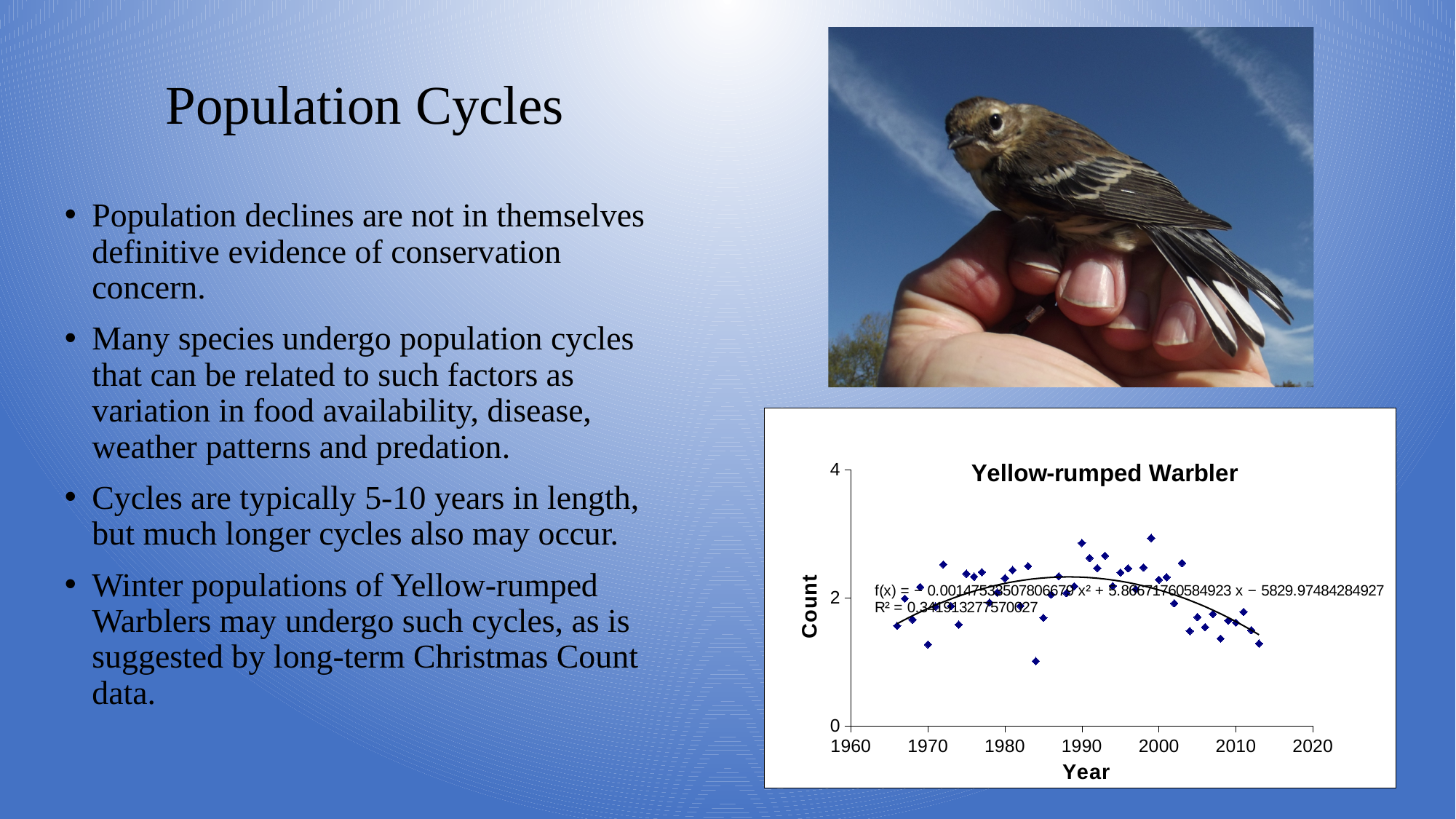
What is the highest value shown on the Count axis? 4 What kind of chart is shown on the slide? Scatter chart In which decade does the highest data point occur? 1990s What is the label on the vertical axis of the chart? Count What is the first year tick shown on the Year axis? 1960 What is the title of the chart? Yellow-rumped Warbler What is the last year tick shown on the Year axis? 2020 In which decade does the lowest data point occur? 1980s Is the highest data point, around 1999, greater or less than 2? greater Does the fitted trend curve rise or fall after 2000? fall Is the lowest data point, around 1984, greater or less than 2? less Is the last data point, around 2013, greater or less than 2? less